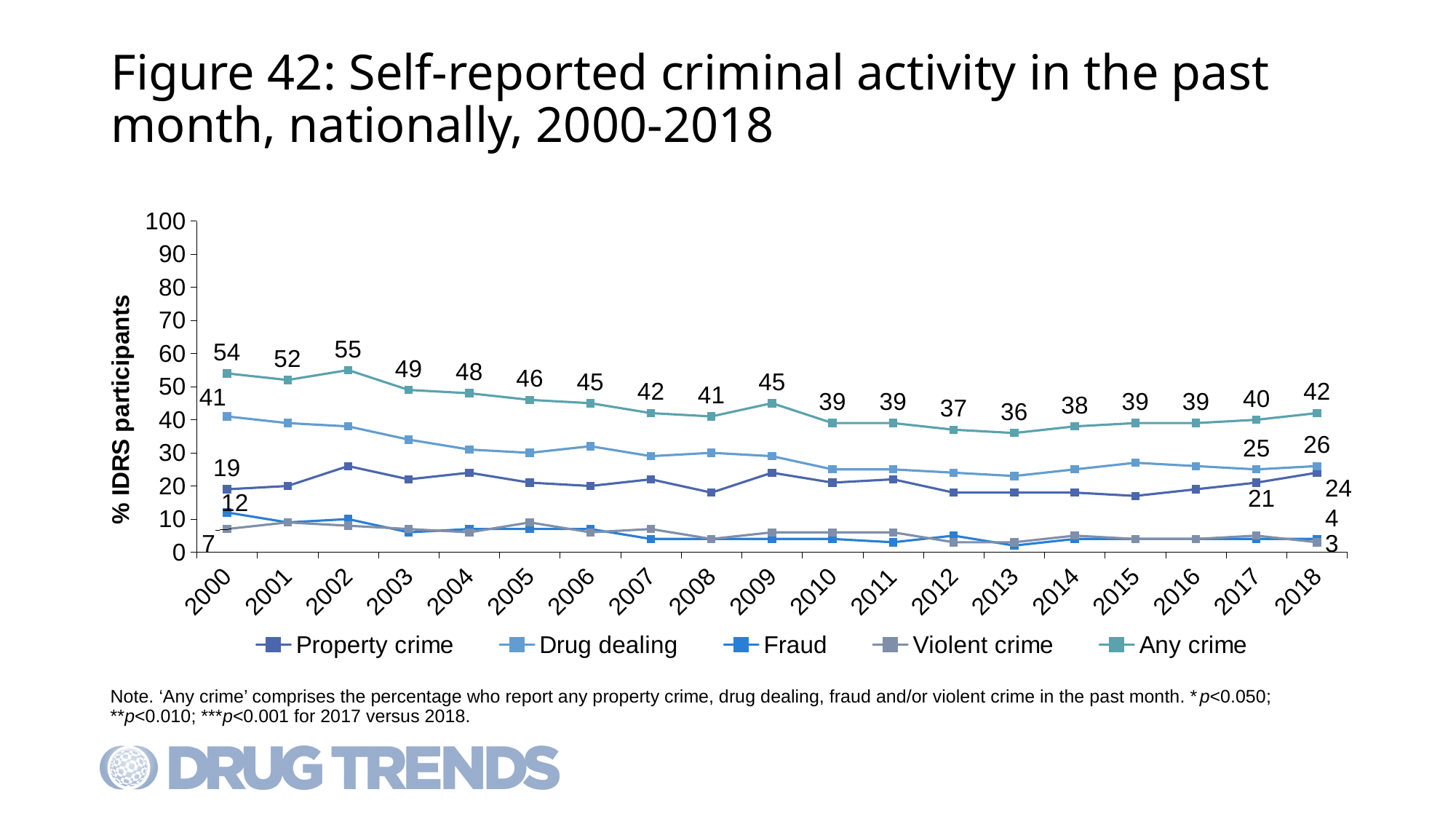
What is the difference between the Any crime value in 2000 and in 2018? 12 Does the Any crime line generally rise or fall from 2000 to 2013? Fall What is the value for Property crime in 2018? 24 Is the value for Drug dealing in 2010 greater or less than 30? less What is the value for Drug dealing in 2000? 41 How many series does the legend list? 5 In 2000, which is larger: Drug dealing or Property crime? Drug dealing What is the value for Any crime in 2002? 55 In which year is the Any crime value highest? 2002 What kind of chart is shown? Line chart What is the value for Fraud in 2000? 12 In which year is the Any crime value lowest? 2013